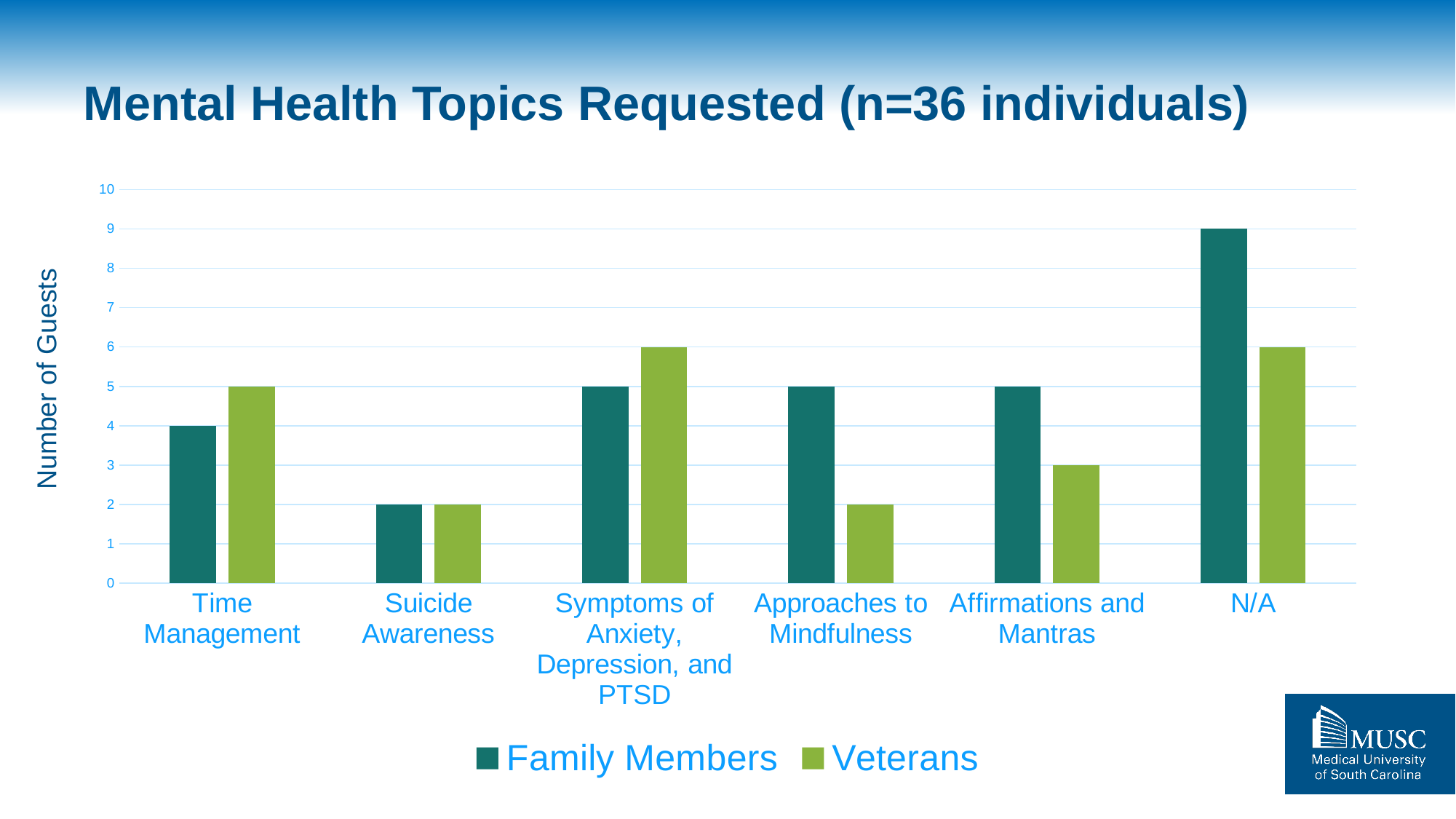
What is the value for Veterans for Time Management? 5 How many series does the legend list? 2 What kind of chart is shown on the slide? bar chart What is the difference between the Family Members and Veterans values for Approaches to Mindfulness? 3 What is the value for Veterans for Symptoms of Anxiety, Depression, and PTSD? 6 Is the Veterans value for N/A greater or less than 5? greater How many categories are shown on the x axis? 6 Which category has the lowest Family Members value? Suicide Awareness Which category has the highest Family Members value? N/A What is the value for Family Members for N/A? 9 What is the label of the y axis? Number of Guests For Affirmations and Mantras, which series has the larger value, Family Members or Veterans? Family Members